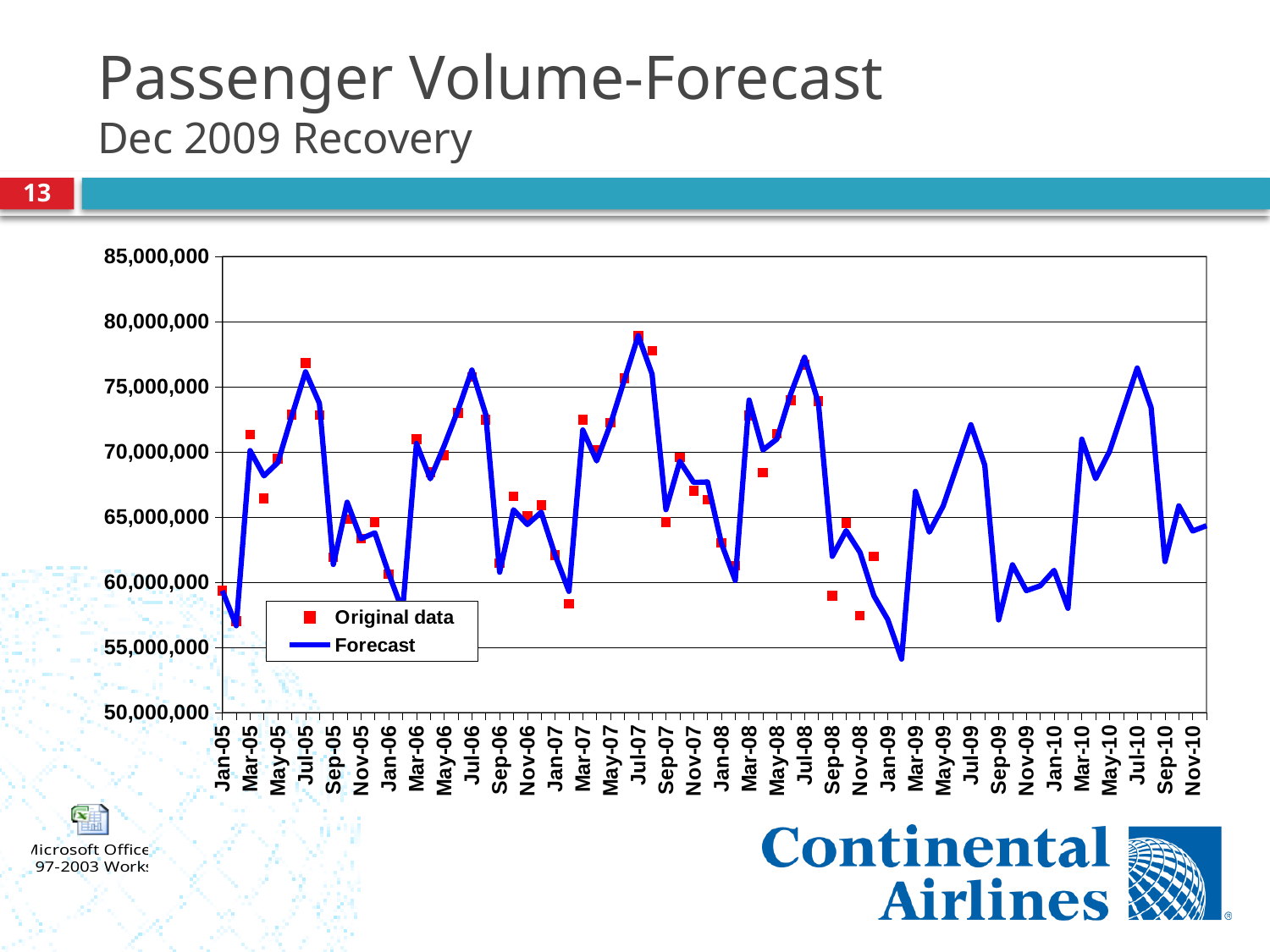
Is the Forecast value for Jul-10 greater or less than 75,000,000? greater Is the Forecast value for Jul-07 greater or less than 75,000,000? greater Does the Forecast line rise or fall from Jan-09 to Jul-09? rise Which is larger, the Forecast value for Jan-09 or for Jan-10? Jan-10 What are the two series named in the legend? Original data and Forecast Is the Original data value for Nov-08 greater or less than 60,000,000? less What kind of chart is shown on the slide? line chart At which month does the Forecast line reach its lowest point? Feb-09 How many series does the legend list? 2 At which month does the Forecast line reach its highest point? Jul-07 What colour is the Forecast line? blue